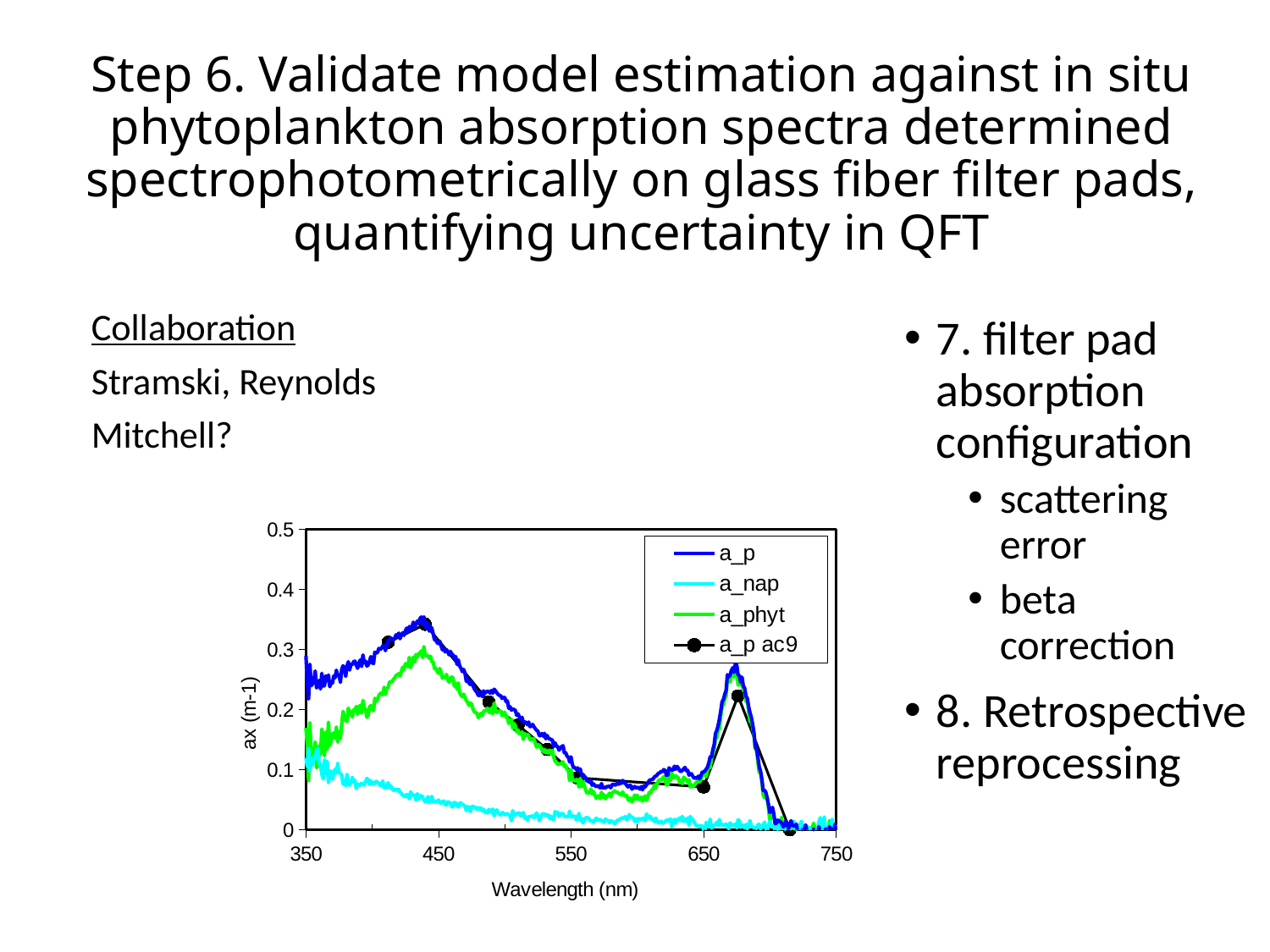
Does the a_nap series generally rise or fall as wavelength increases from 350 to 750 nm? fall Is the value of a_p at 350 nm greater or less than 0.2? greater What is the title of the y axis of the chart? ax (m-1) Is the value of a_phyt at 550 nm greater or less than 0.2? less How many series does the chart legend list? 4 What kind of chart is shown on the slide? line chart What is the title of the x axis of the chart? Wavelength (nm) Which series reaches the highest value on the chart? a_p Is the value of a_nap at 450 nm greater or less than 0.1? less At 450 nm, which series has the larger value, a_p or a_nap? a_p At 450 nm, which series has the larger value, a_phyt or a_nap? a_phyt